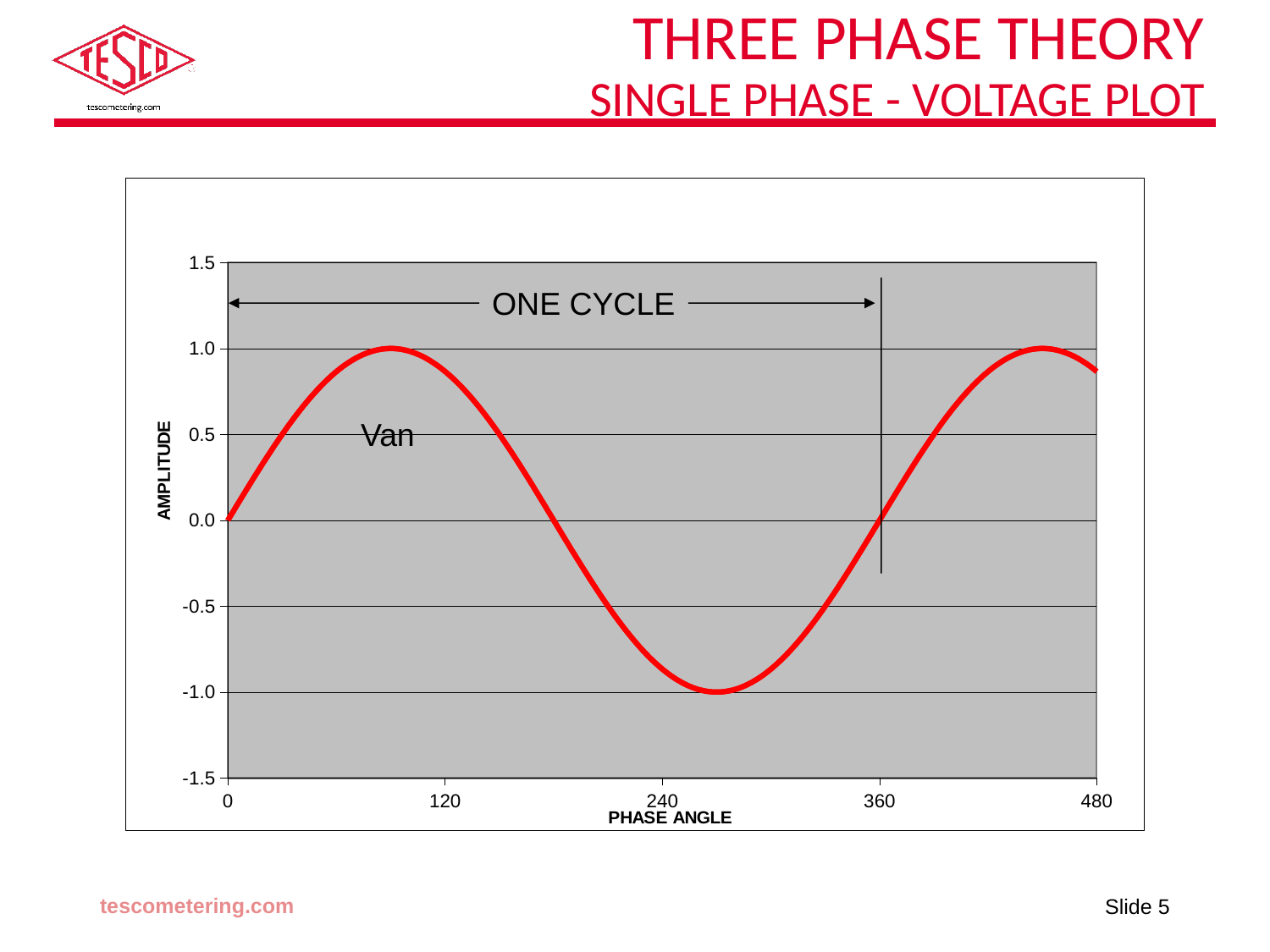
What is the title of the x axis? PHASE ANGLE Is the amplitude of Van at a phase angle of 120 greater or less than 0.5? greater Which is larger, the amplitude of Van at phase angle 120 or at phase angle 240? 120 What is the amplitude of Van at a phase angle of 360? 0.0 What kind of chart is shown on the slide? line chart What is the maximum amplitude reached by the Van curve? 1.0 Is the amplitude of Van at a phase angle of 480 greater or less than 0.5? greater What is the minimum amplitude reached by the Van curve? -1.0 What is the label of the plotted curve? Van Does the Van curve rise or fall between phase angles 120 and 240? fall Is the amplitude of Van at a phase angle of 240 greater or less than -0.5? less What is the amplitude of Van at a phase angle of 0? 0.0